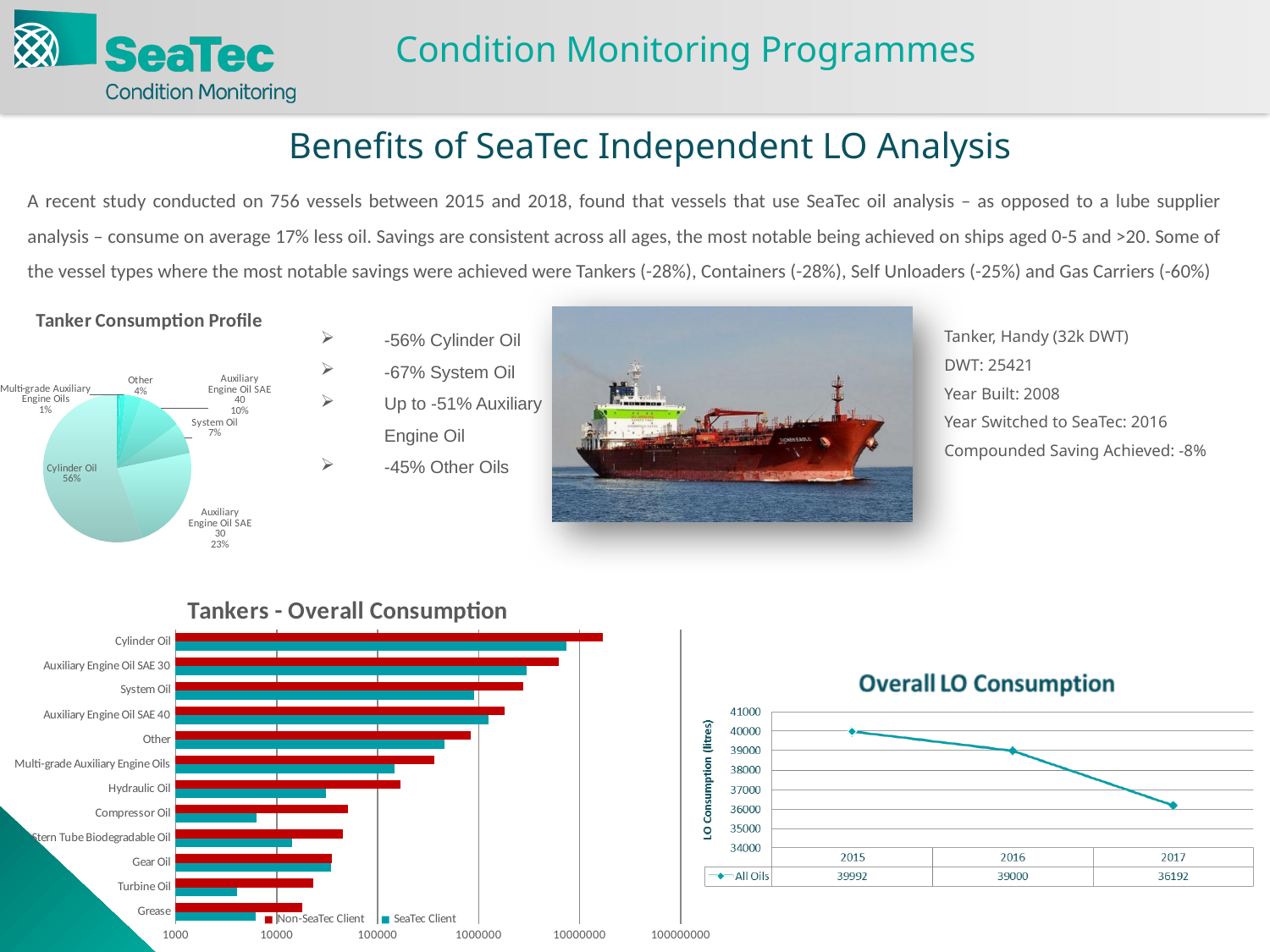
In the Tanker Consumption Profile pie chart, which is larger, the share of System Oil or the share of Other? System Oil In the Tankers - Overall Consumption chart, is the SeaTec Client value for Turbine Oil greater or less than 10000? less In the Overall LO Consumption chart, what is the difference between the All Oils values for 2015 and 2017? 3800 In the Tanker Consumption Profile pie chart, what is the difference between the shares of Auxiliary Engine Oil SAE 30 and Auxiliary Engine Oil SAE 40? 13% What kind of chart is Tankers - Overall Consumption? Bar chart In the Tankers - Overall Consumption chart, is the Non-SeaTec Client value for Compressor Oil greater or less than 10000? greater In the Tanker Consumption Profile pie chart, what share does Cylinder Oil have? 56% In the Overall LO Consumption chart, do the All Oils values rise or fall from 2015 to 2017? fall How many series does the legend of the Tankers - Overall Consumption chart list? 2 In the Overall LO Consumption chart, what is the All Oils value for 2017? 36192